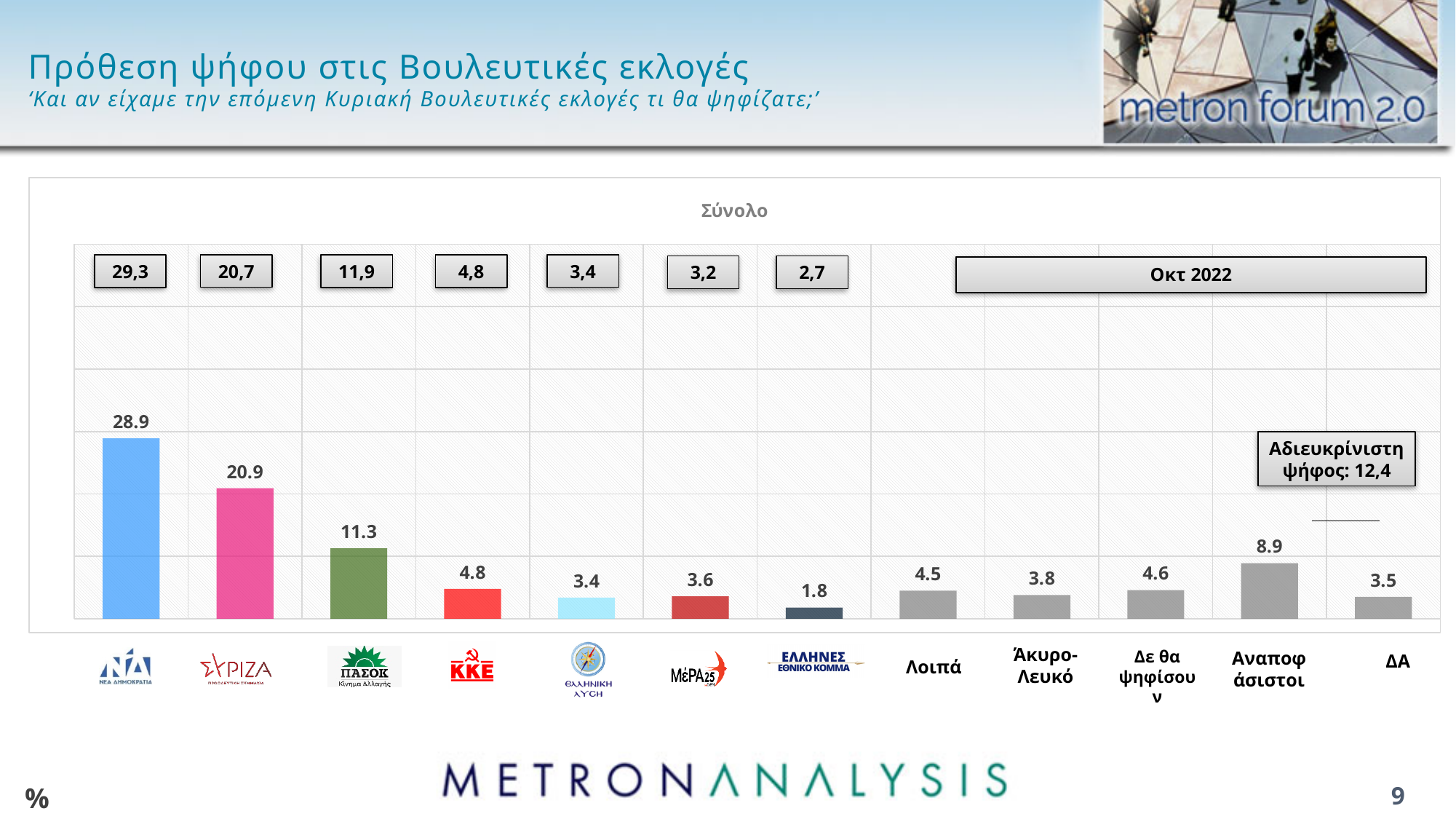
Which category has the lowest bar? ΕΛΛΗΝΕΣ (Εθνικό Κόμμα) What is the difference between the bars for ΝΕΑ ΔΗΜΟΚΡΑΤΙΑ and ΣΥΡΙΖΑ? 8.0 How many bars are plotted in the chart? 12 Which category has the highest bar? ΝΕΑ ΔΗΜΟΚΡΑΤΙΑ What is the value of the bar for ΣΥΡΙΖΑ? 20.9 What is the Οκτ 2022 value shown in the box above the ΠΑΣΟΚ bar? 11,9 What kind of chart is shown on the slide? Bar chart Which is larger, the bar for ΚΚΕ or the bar for ΠΑΣΟΚ? ΠΑΣΟΚ What is the value of the bar for ΜέΡΑ25? 3.6 What is the value of the bar for ΝΕΑ ΔΗΜΟΚΡΑΤΙΑ? 28.9 What is the value of the bar for Αναποφάσιστοι? 8.9 What is the title shown above the chart? Σύνολο